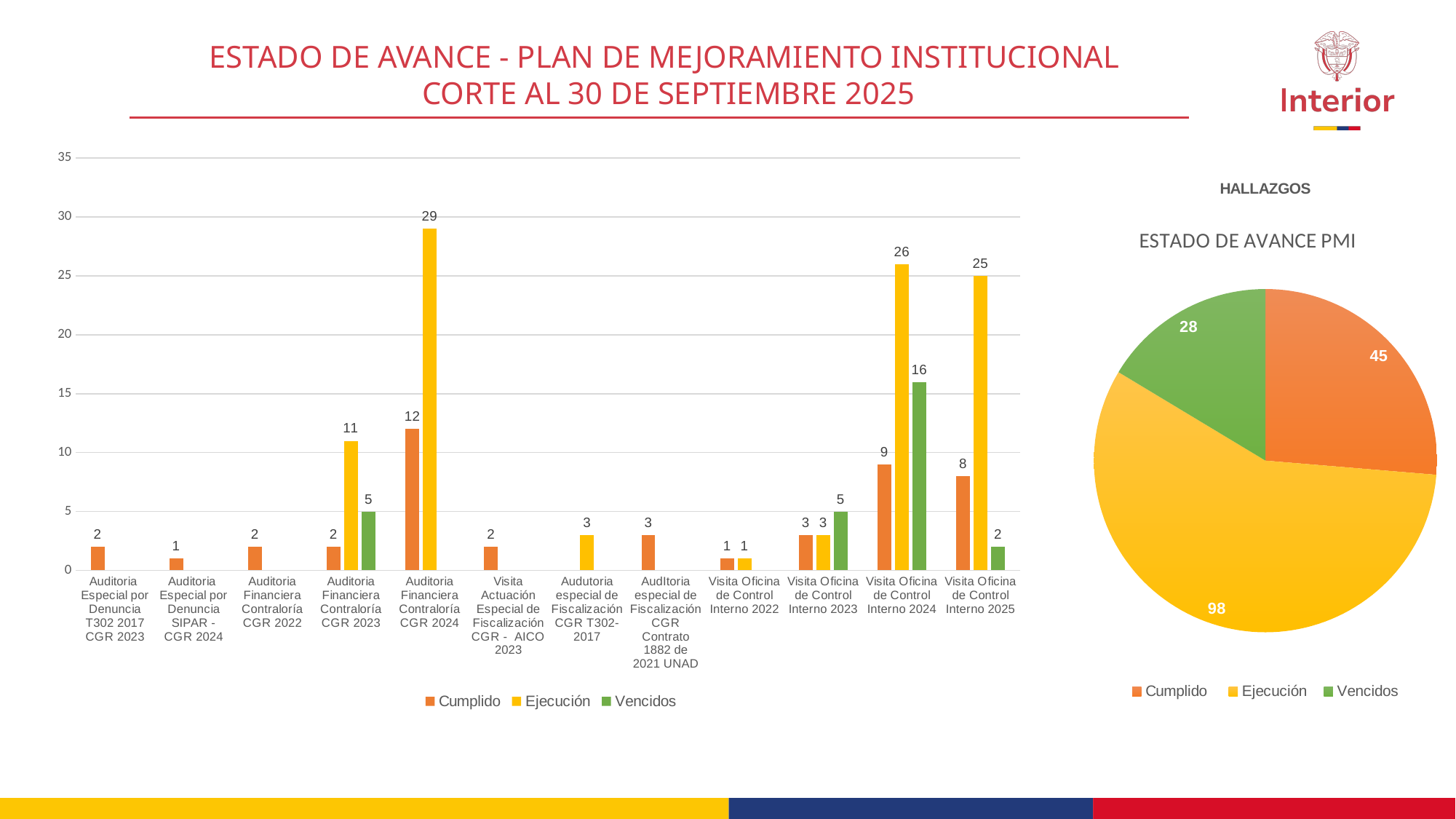
In the pie chart titled ESTADO DE AVANCE PMI, what is the value for Ejecución? 98 In the bar chart on the left, what is the difference between the Ejecución values for Visita Oficina de Control Interno 2024 and Visita Oficina de Control Interno 2025? 1 In the bar chart on the left, what is the Vencidos value for Visita Oficina de Control Interno 2024? 16 In the bar chart on the left, which is larger: the Cumplido value for Auditoria Financiera Contraloría CGR 2024 or the Cumplido value for Visita Oficina de Control Interno 2024? Auditoria Financiera Contraloría CGR 2024 In the bar chart on the left, which category has the highest Ejecución value? Auditoria Financiera Contraloría CGR 2024 In the bar chart on the left, what is the Ejecución value for Auditoria Financiera Contraloría CGR 2024? 29 In the bar chart on the left, what is the Cumplido value for Visita Oficina de Control Interno 2025? 8 In the pie chart titled ESTADO DE AVANCE PMI, what is the difference between the Cumplido and Vencidos values? 17 In the pie chart titled ESTADO DE AVANCE PMI, which slice is the smallest? Vencidos How many series does the legend of the bar chart on the left list? 3 In the bar chart on the left, which category has the highest Vencidos value? Visita Oficina de Control Interno 2024 How many categories are shown on the x axis of the bar chart on the left? 12